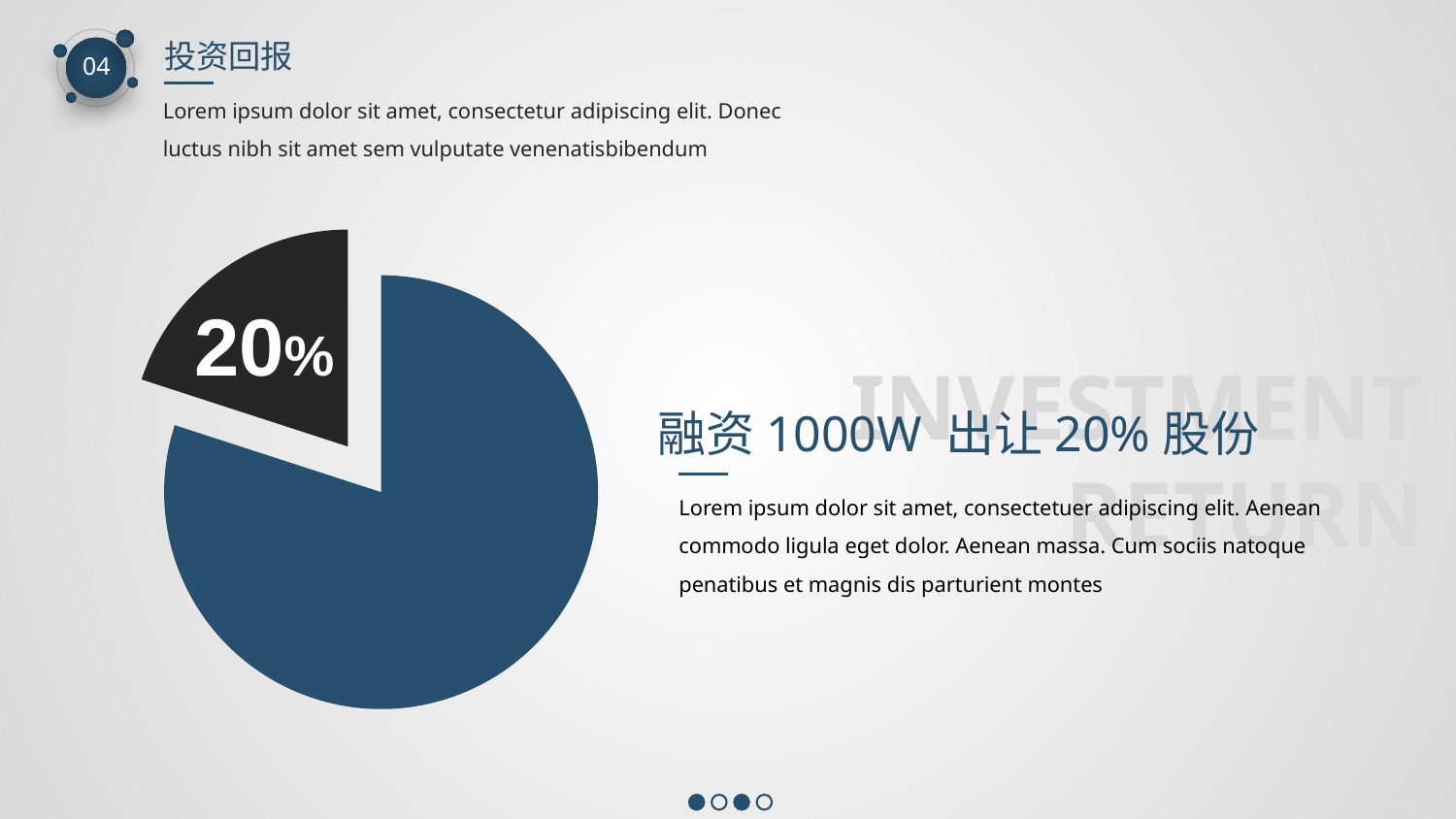
What colour is the largest slice of the pie chart? blue Which slice of the pie is larger, the black slice or the blue slice? the blue slice Which slice of the pie is the smallest? the black slice Is the share of the blue slice greater or less than 50%? greater What percentage label is printed on the pie chart? 20% What share of the pie does the black (exploded) slice represent? 20% What kind of chart is shown on the slide? pie chart Which slice of the pie is the largest? the blue slice Is the share of the black slice greater or less than 50%? less Which slice of the pie is pulled out (exploded) from the rest? the black 20% slice How many slices does the pie chart have? 2